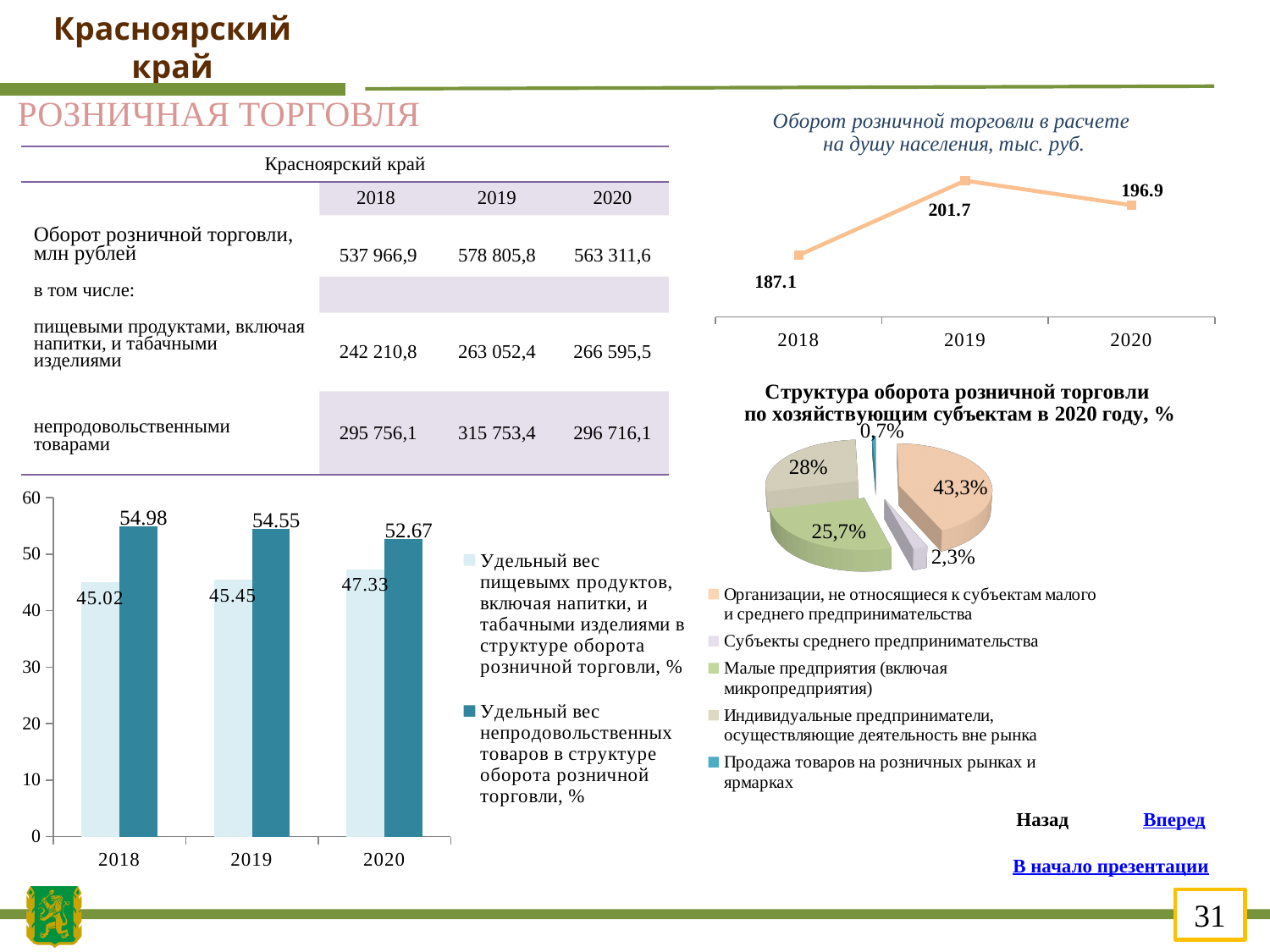
In the line chart 'Оборот розничной торговли в расчете на душу населения, тыс. руб.', does the value rise or fall from 2019 to 2020? fall In the pie chart 'Структура оборота розничной торговли по хозяйствующим субъектам в 2020 году, %', what is the share of 'Малые предприятия (включая микропредприятия)'? 25,7% In the bar chart at the bottom left of the slide, what is the value of 'Удельный вес непродовольственных товаров' for 2020? 52.67 In the bar chart at the bottom left of the slide, what is the value of 'Удельный вес пищевых продуктов' for 2018? 45.02 In the line chart 'Оборот розничной торговли в расчете на душу населения, тыс. руб.', what is the value for 2019? 201.7 In the bar chart at the bottom left of the slide, how many series does the legend list? 2 In the pie chart 'Структура оборота розничной торговли по хозяйствующим субъектам в 2020 году, %', which category has the smallest share? Продажа товаров на розничных рынках и ярмарках In the bar chart at the bottom left of the slide, which year has the highest value for 'Удельный вес непродовольственных товаров'? 2018 In the line chart 'Оборот розничной торговли в расчете на душу населения, тыс. руб.', which year has the lowest value? 2018 In the line chart 'Оборот розничной торговли в расчете на душу населения, тыс. руб.', by how much did the value change from 2018 to 2019? 14.6 In the bar chart at the bottom left of the slide, what is the difference between the two series in 2019? 9.10 What type of chart is shown at the bottom left of the slide? bar chart